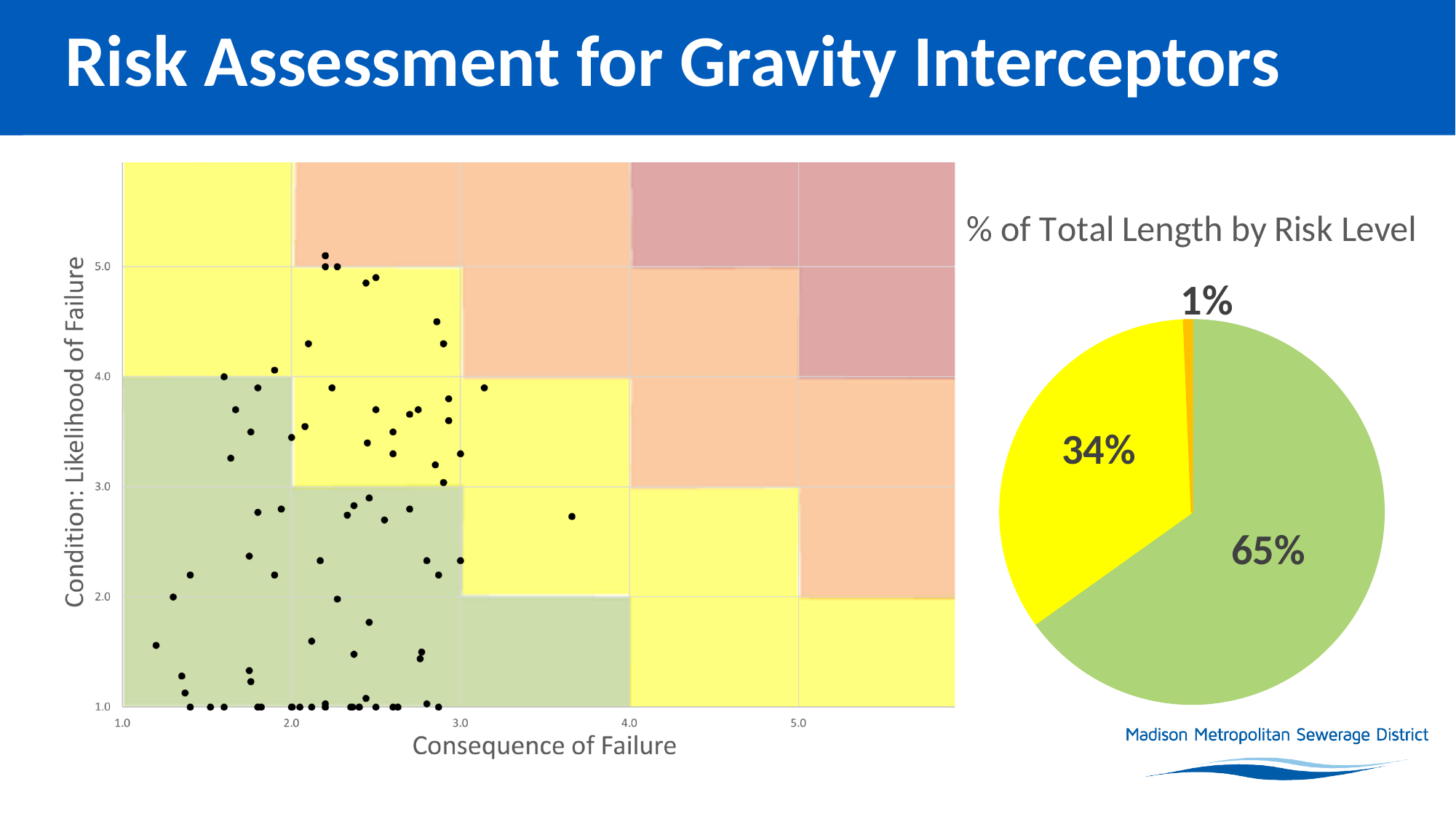
In the pie chart '% of Total Length by Risk Level', what is the difference between the largest slice and the second-largest slice? 31% In the pie chart '% of Total Length by Risk Level', what is the value of the largest slice? 65% In the pie chart '% of Total Length by Risk Level', what do the three slice values add up to? 100% In the pie chart '% of Total Length by Risk Level', what is the value of the yellow slice? 34% In the pie chart '% of Total Length by Risk Level', what is the value of the smallest slice? 1% How many slices does the pie chart '% of Total Length by Risk Level' have? 3 What kind of chart is the chart on the left of the slide? scatter plot What kind of chart is the chart on the right of the slide? pie chart What is the title of the chart on the right of the slide? % of Total Length by Risk Level In the pie chart '% of Total Length by Risk Level', which is larger, the green slice or the yellow slice? the green slice What is the x-axis title of the chart on the left of the slide? Consequence of Failure